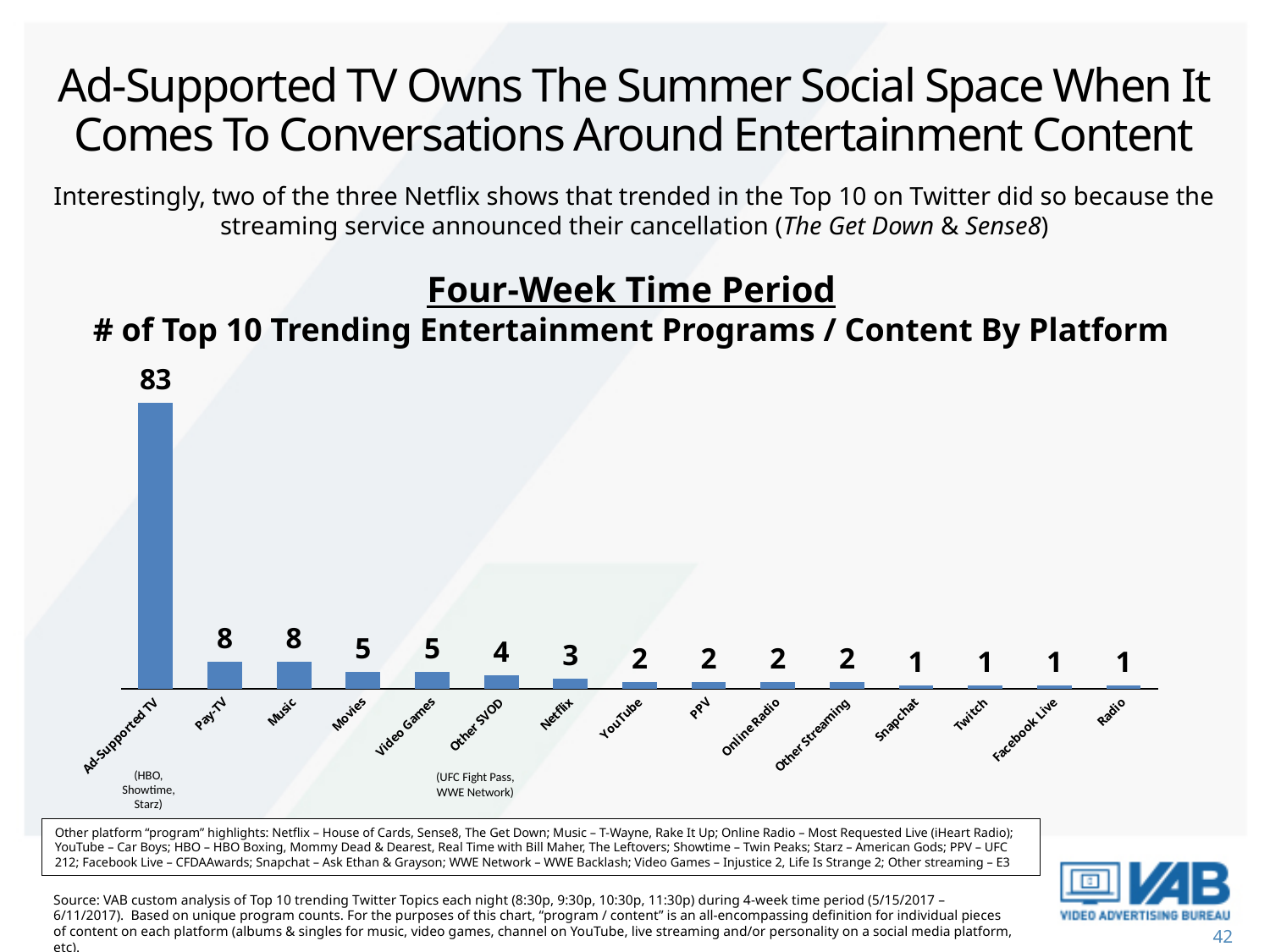
What is the value for Ad-Supported TV? 83 Which platform has the highest number of Top 10 trending entertainment programs? Ad-Supported TV What is the value for Other SVOD? 4 Do the values rise or fall moving from left to right along the x axis? Fall How many platforms are shown on the x axis? 15 What is the difference between the values for Music and Movies? 3 How many platforms have a value of 1? 4 What kind of chart is shown on the slide? Bar chart What is the value for Netflix? 3 Which is larger, the value for Video Games or the value for YouTube? Video Games What is the difference between the values for Ad-Supported TV and Pay-TV? 75 What is the title of the chart? Four-Week Time Period # of Top 10 Trending Entertainment Programs / Content By Platform